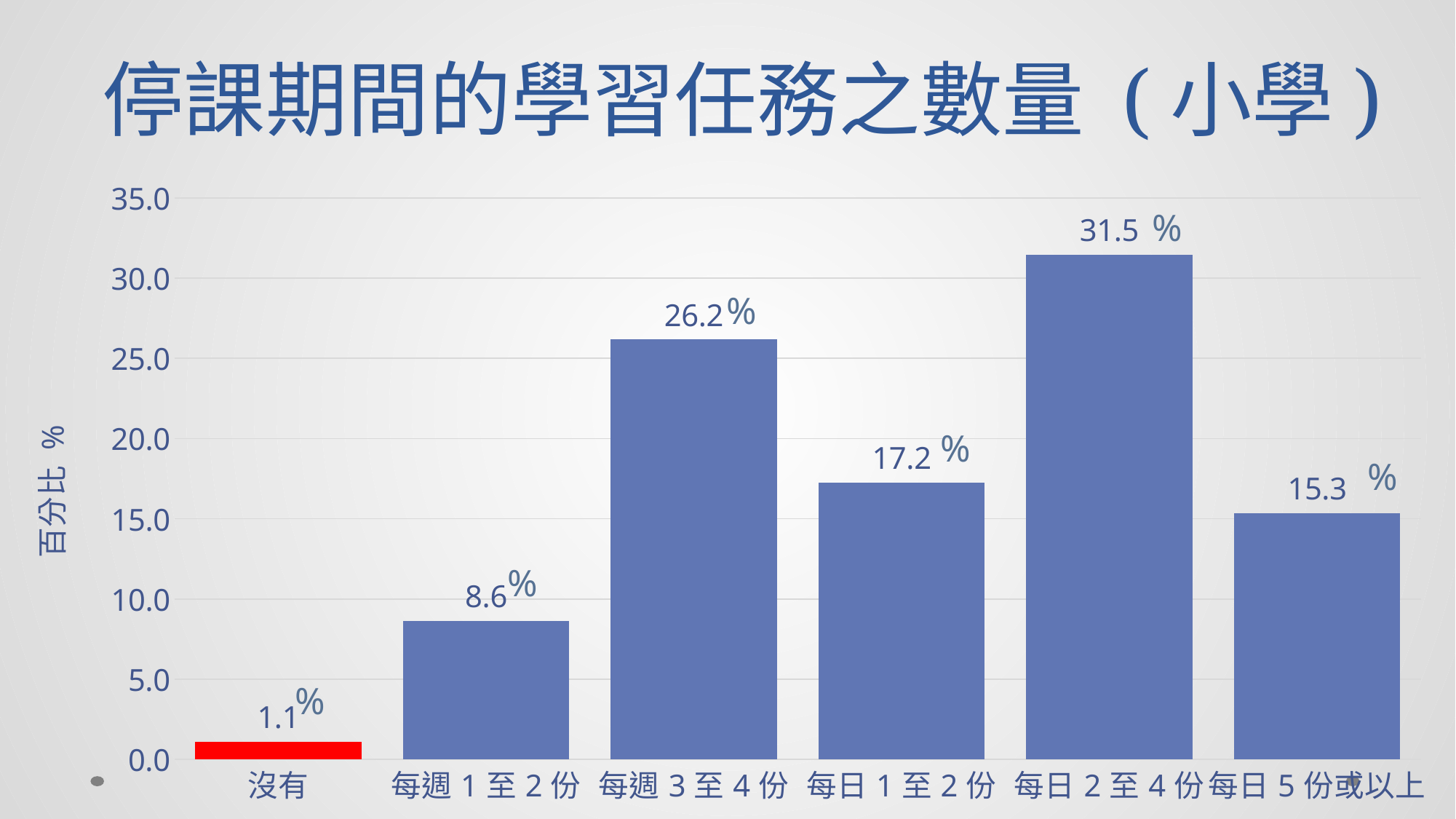
Which bar is coloured red? 沒有 What kind of chart is shown on the slide? bar chart How many categories are shown on the x axis? 6 Is the value for 每週 1 至 2 份 greater or less than 10.0? less What is the difference between the values for 每日 2 至 4 份 and 每週 3 至 4 份? 5.3% What is the value for 每日 2 至 4 份? 31.5% Which category has the highest value? 每日 2 至 4 份 What is the title of the chart? 停課期間的學習任務之數量（小學） What is the value for 每週 3 至 4 份? 26.2% What is the value for 沒有? 1.1% Which category has the lowest value? 沒有 Which is larger, the value for 每日 1 至 2 份 or 每日 5 份或以上? 每日 1 至 2 份